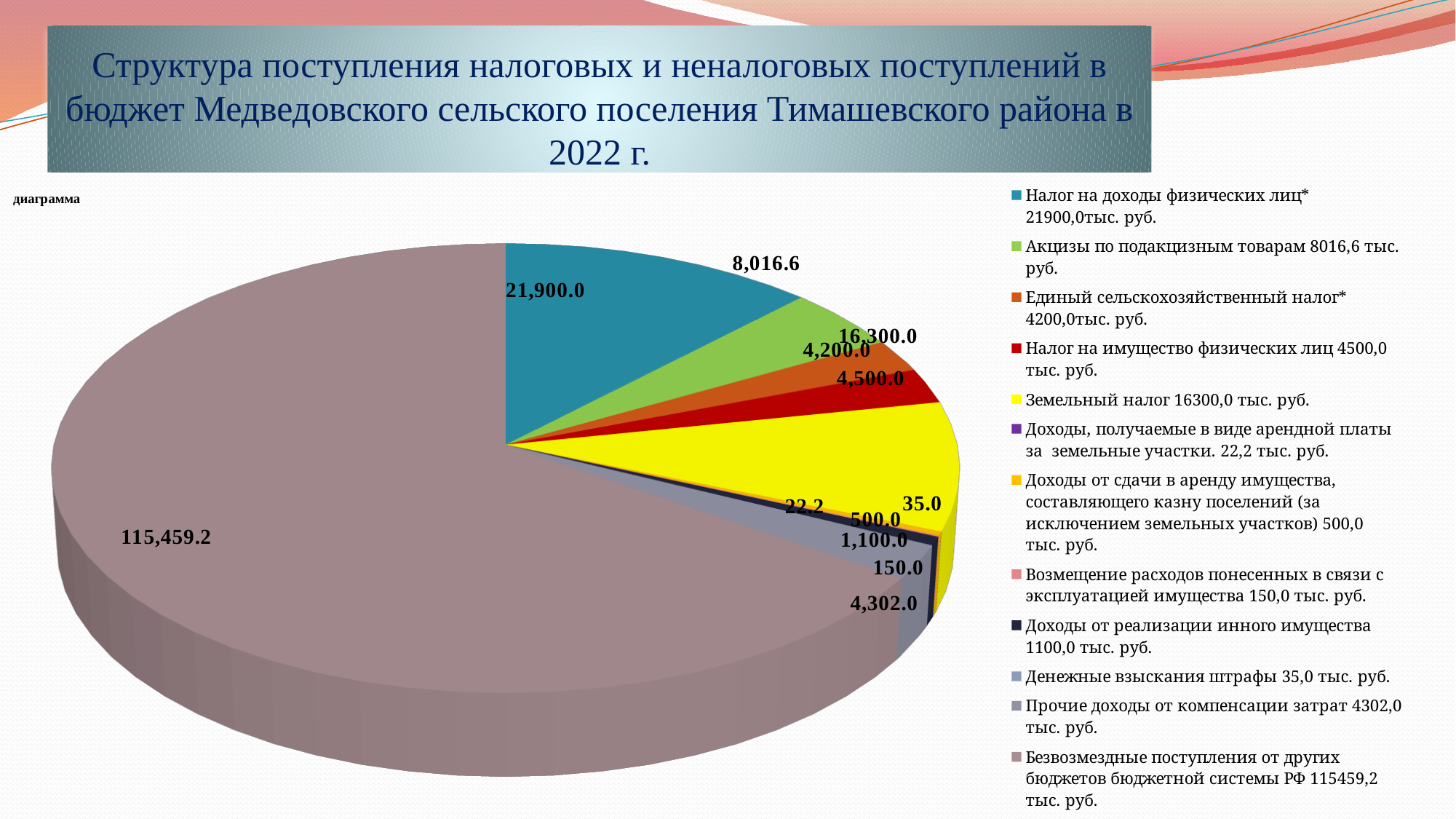
Which category has the largest slice of the pie? Безвозмездные поступления от других бюджетов бюджетной системы РФ How many categories does the legend list? 12 What type of chart is shown on the slide? Pie chart What is the value of the slice for Земельный налог? 16,300.0 What is the value of the slice for Безвозмездные поступления от других бюджетов бюджетной системы РФ? 115,459.2 What colour is the slice for Земельный налог? Yellow What is the value of the slice for Налог на доходы физических лиц? 21,900.0 What is the value of the slice for Акцизы по подакцизным товарам? 8,016.6 Which is larger: the value for Налог на имущество физических лиц or the value for Единый сельскохозяйственный налог? Налог на имущество физических лиц What is the difference between the values for Налог на доходы физических лиц and Земельный налог? 5,600.0 What is the value of the slice for Прочие доходы от компенсации затрат? 4,302.0 Which category has the smallest slice of the pie? Доходы, получаемые в виде арендной платы за земельные участки